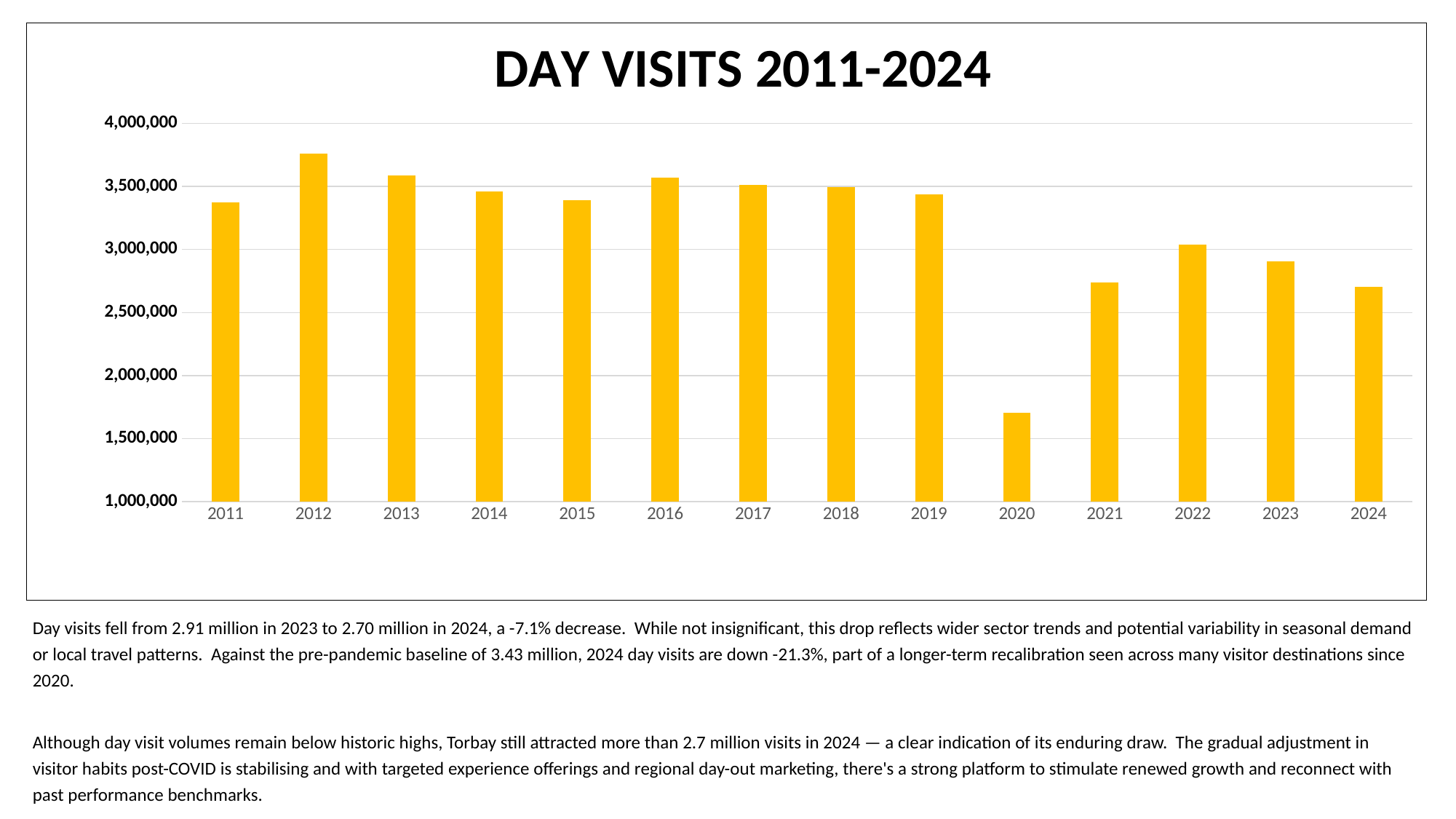
How many years are plotted on the chart? 14 What is the title of the chart? DAY VISITS 2011-2024 Which year has the lowest number of day visits? 2020 Which year has more day visits, 2013 or 2014? 2013 Do day visits rise or fall from 2012 to 2015? fall What type of chart is shown on the slide? Bar chart Is the value for 2012 greater or less than 3,500,000? greater Is the value for 2020 greater or less than 2,000,000? less Which year has the highest number of day visits? 2012 Which year has more day visits, 2021 or 2022? 2022 Is the value for 2011 greater or less than 3,500,000? less